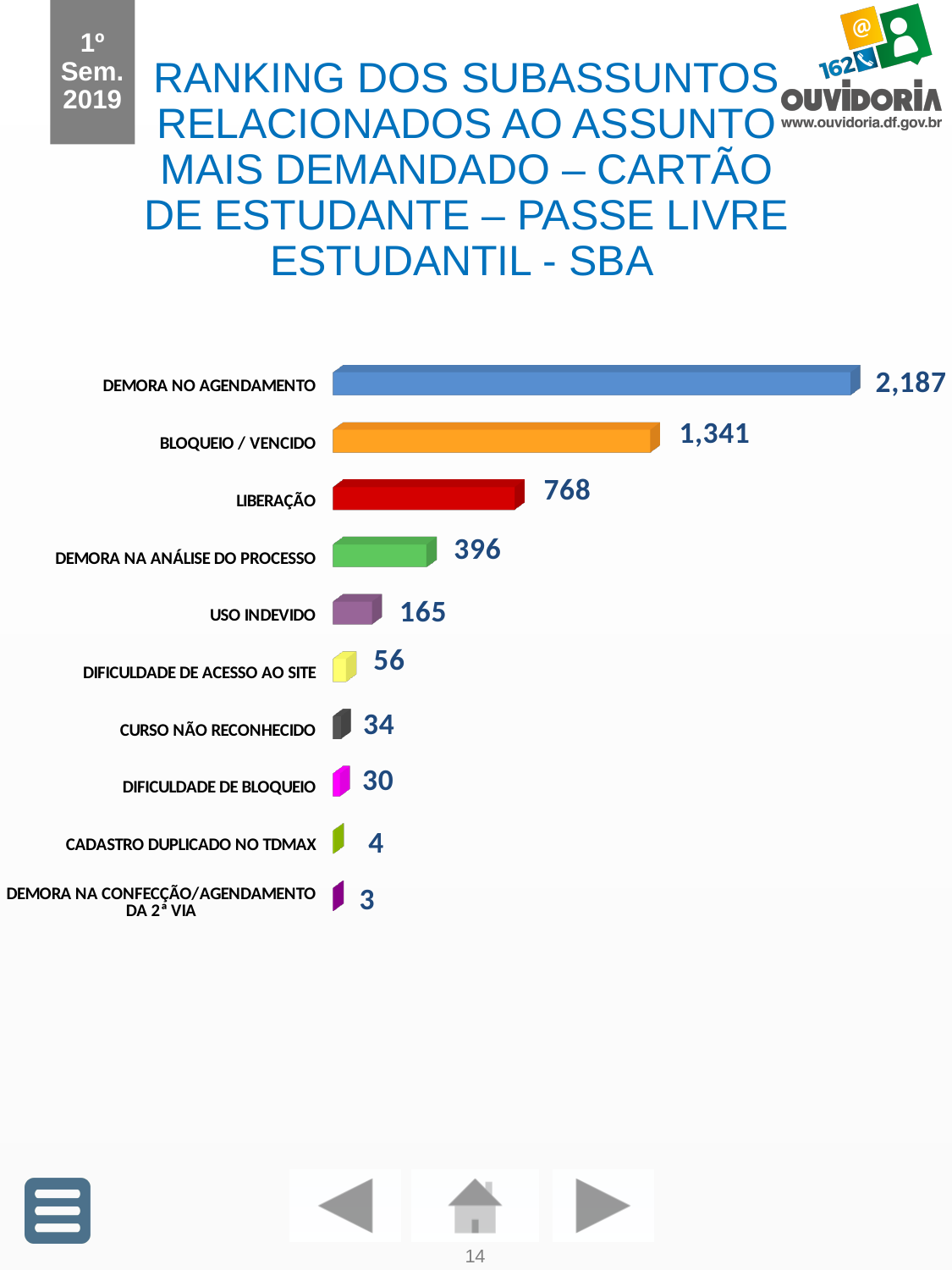
Which is larger, the value for CURSO NÃO RECONHECIDO or DIFICULDADE DE BLOQUEIO? CURSO NÃO RECONHECIDO What is the value for DEMORA NO AGENDAMENTO? 2,187 What is the value for USO INDEVIDO? 165 What is the difference between the values for LIBERAÇÃO and DEMORA NA ANÁLISE DO PROCESSO? 372 How many categories are shown in the chart? 10 What is the value for BLOQUEIO / VENCIDO? 1,341 What kind of chart is shown on the slide? bar chart Which category has the lowest value? DEMORA NA CONFECÇÃO/AGENDAMENTO DA 2ª VIA What is the difference between the values for DEMORA NO AGENDAMENTO and BLOQUEIO / VENCIDO? 846 What is the value for LIBERAÇÃO? 768 What is the value for CADASTRO DUPLICADO NO TDMAX? 4 Which category has the highest value? DEMORA NO AGENDAMENTO